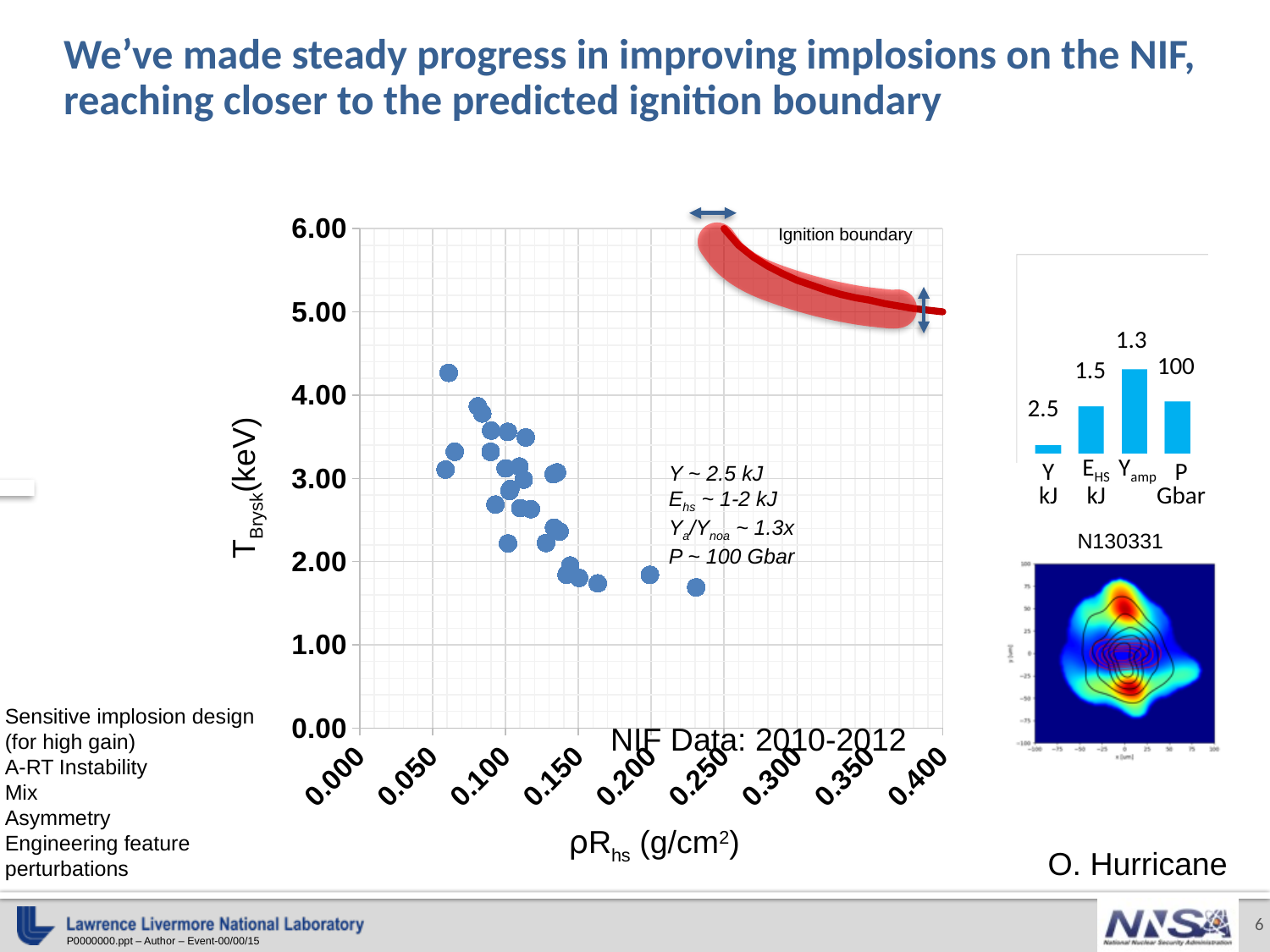
How many bars does the small bar chart on the right have? 4 In the scatter chart, what is the label of the x axis? ρR_hs (g/cm²) In the small bar chart on the right, what value is printed above the Y bar? 2.5 In the small bar chart on the right, what value is printed above the Y_amp bar? 1.3 In the scatter chart, is the lowest plotted point greater or less than 2.00 keV? less In the scatter chart, do the plotted T_Brysk values generally rise or fall as ρR_hs increases? fall What kind of chart is the large chart in the centre of the slide? scatter chart What kind of chart is the small chart on the right of the slide with bars labelled Y, E_HS, Y_amp and P? bar chart In the scatter chart, is the highest plotted point greater or less than 4.00 keV? greater In the small bar chart on the right, what value is printed above the E_HS bar? 1.5 In the small bar chart on the right, what unit is shown under the P bar? Gbar In the small bar chart on the right, what value is printed above the P bar? 100